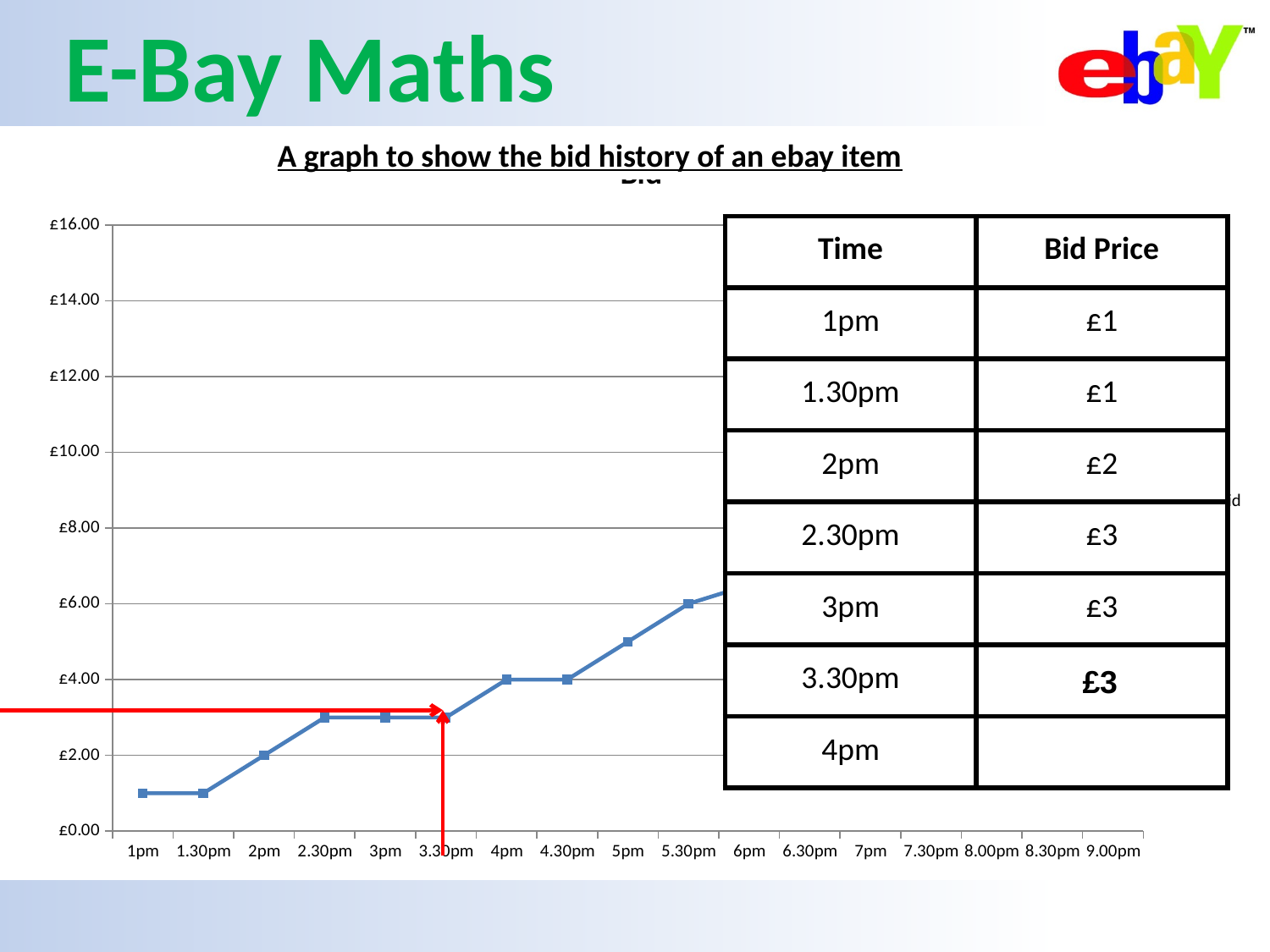
What is the bid price at 2pm? £2 What is the bid price at 5.30pm? £6.00 What is the bid price at 1pm? £1 What is the bid price at 2.30pm? £3 What kind of chart is shown on the slide? line chart Is the bid price at 5pm greater or less than £4.00? greater Which has the higher bid price, 2pm or 2.30pm? 2.30pm By how much does the bid price at 2.30pm exceed the bid price at 1pm? £2 Is the bid price at 5pm greater or less than £6.00? less What is the bid price at 4pm? £4.00 Does the bid price rise or fall from 1pm to 5.30pm? rise What is the title of the graph? A graph to show the bid history of an ebay item